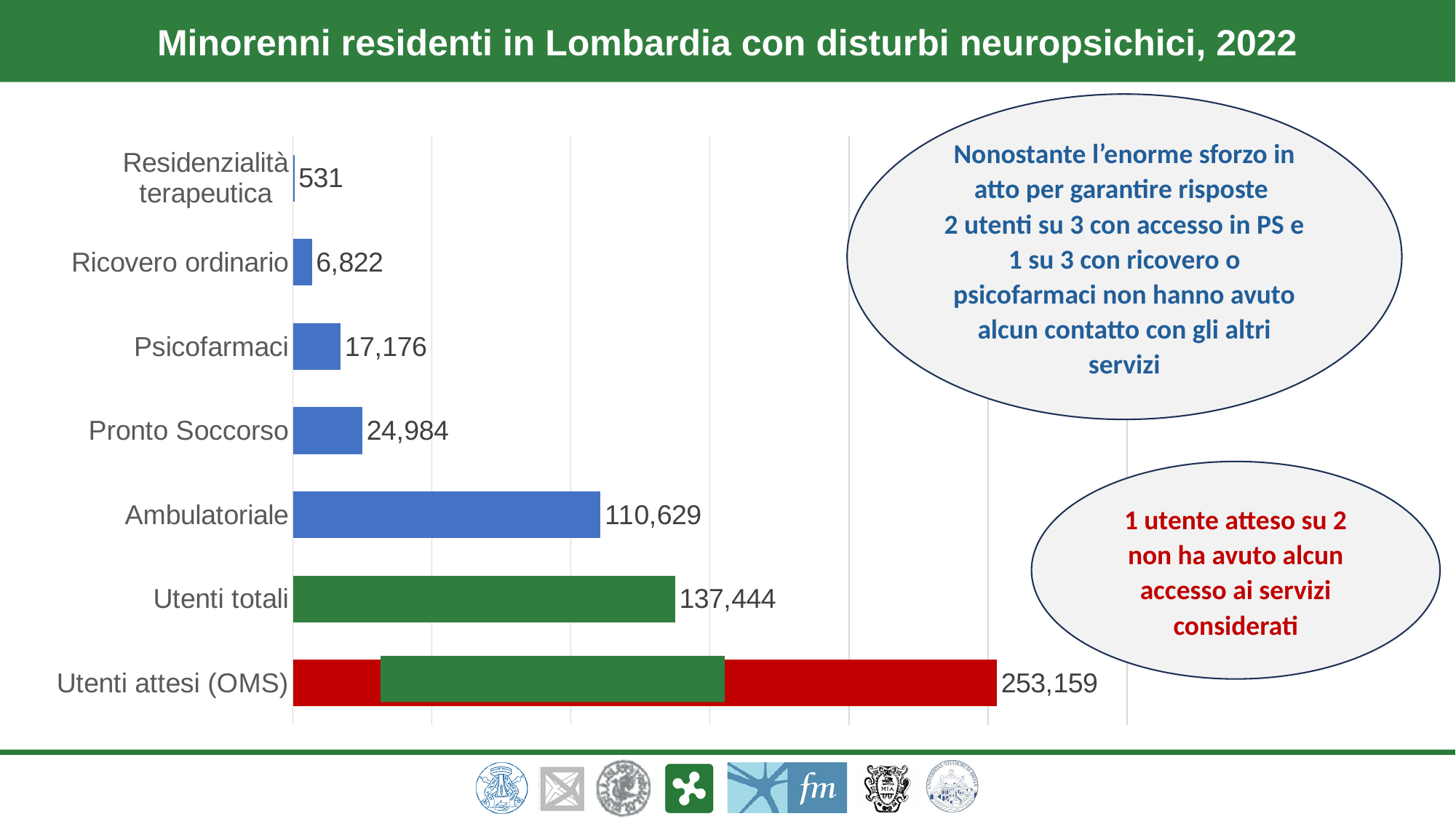
What kind of chart is shown on the slide? Bar chart What is the difference between Utenti attesi (OMS) and Utenti totali? 115,715 What colour is the bar for Utenti totali? Green How many categories are shown in the chart? 7 Which category has the highest value? Utenti attesi (OMS) What is the value for Residenzialità terapeutica? 531 What is the value for Pronto Soccorso? 24,984 What is the value for Ambulatoriale? 110,629 Which is larger, Ricovero ordinario or Psicofarmaci? Psicofarmaci What is the difference between Pronto Soccorso and Psicofarmaci? 7,808 Which category has the lowest value? Residenzialità terapeutica What is the value for Utenti attesi (OMS)? 253,159